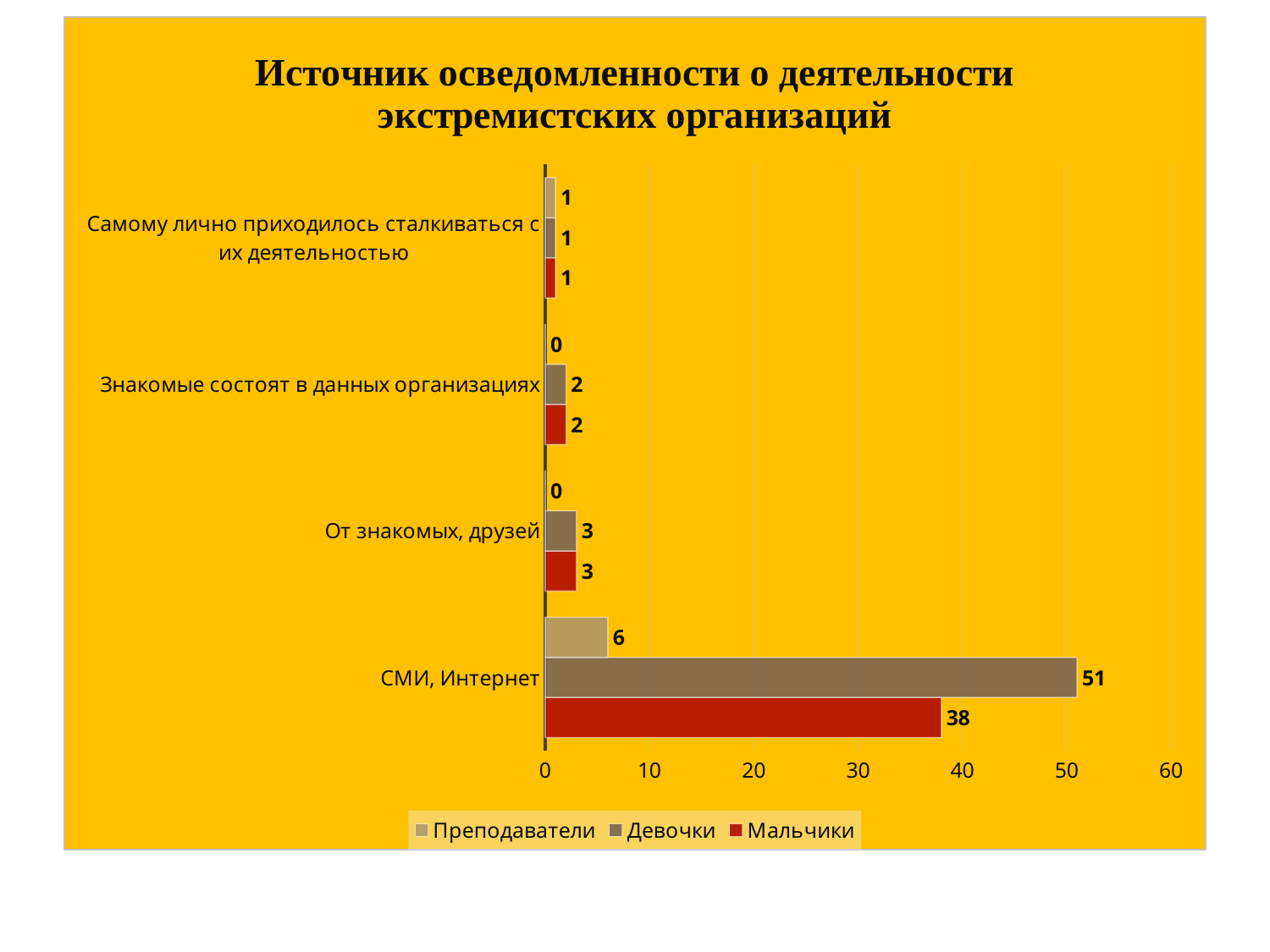
What value is shown for Мальчики in the category СМИ, Интернет? 38 For СМИ, Интернет, which is larger: the value for Девочки or the value for Мальчики? Девочки What kind of chart is shown on the slide? Bar chart How many categories are shown on the chart? 4 What value is shown for Преподаватели in the category От знакомых, друзей? 0 What is the difference between the Девочки and Мальчики values for СМИ, Интернет? 13 What value is shown for Преподаватели in the category СМИ, Интернет? 6 What value is shown for Девочки in the category СМИ, Интернет? 51 What is the title of the chart? Источник осведомленности о деятельности экстремистских организаций What is the total of the three values for the category Знакомые состоят в данных организациях? 4 Which category has the highest value for Девочки? СМИ, Интернет How many series does the legend list? 3